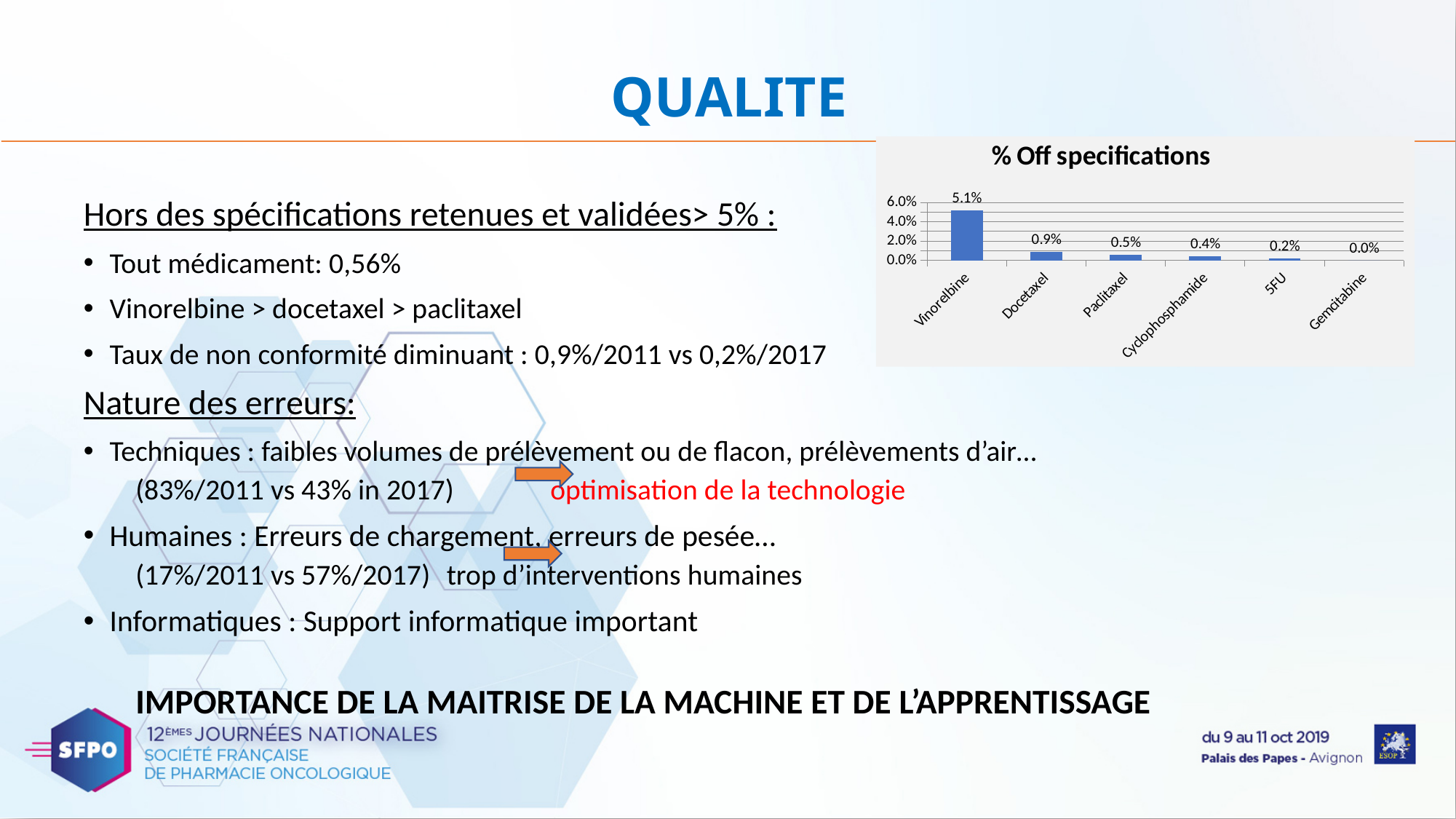
Which drug has the lowest % off specifications? Gemcitabine What is the title of the chart on the slide? % Off specifications What is the % off specifications value for Cyclophosphamide? 0.4% How many drugs are shown on the x axis of the chart? 6 What is the % off specifications value for Docetaxel? 0.9% What is the % off specifications value for Vinorelbine? 5.1% Do the values rise or fall from left to right along the x axis? fall Which drug has the highest % off specifications? Vinorelbine Which has a higher % off specifications, Paclitaxel or 5FU? Paclitaxel What type of chart is shown on the slide? bar chart What is the % off specifications value for Gemcitabine? 0.0% What is the difference between the % off specifications for Vinorelbine and Docetaxel? 4.2%